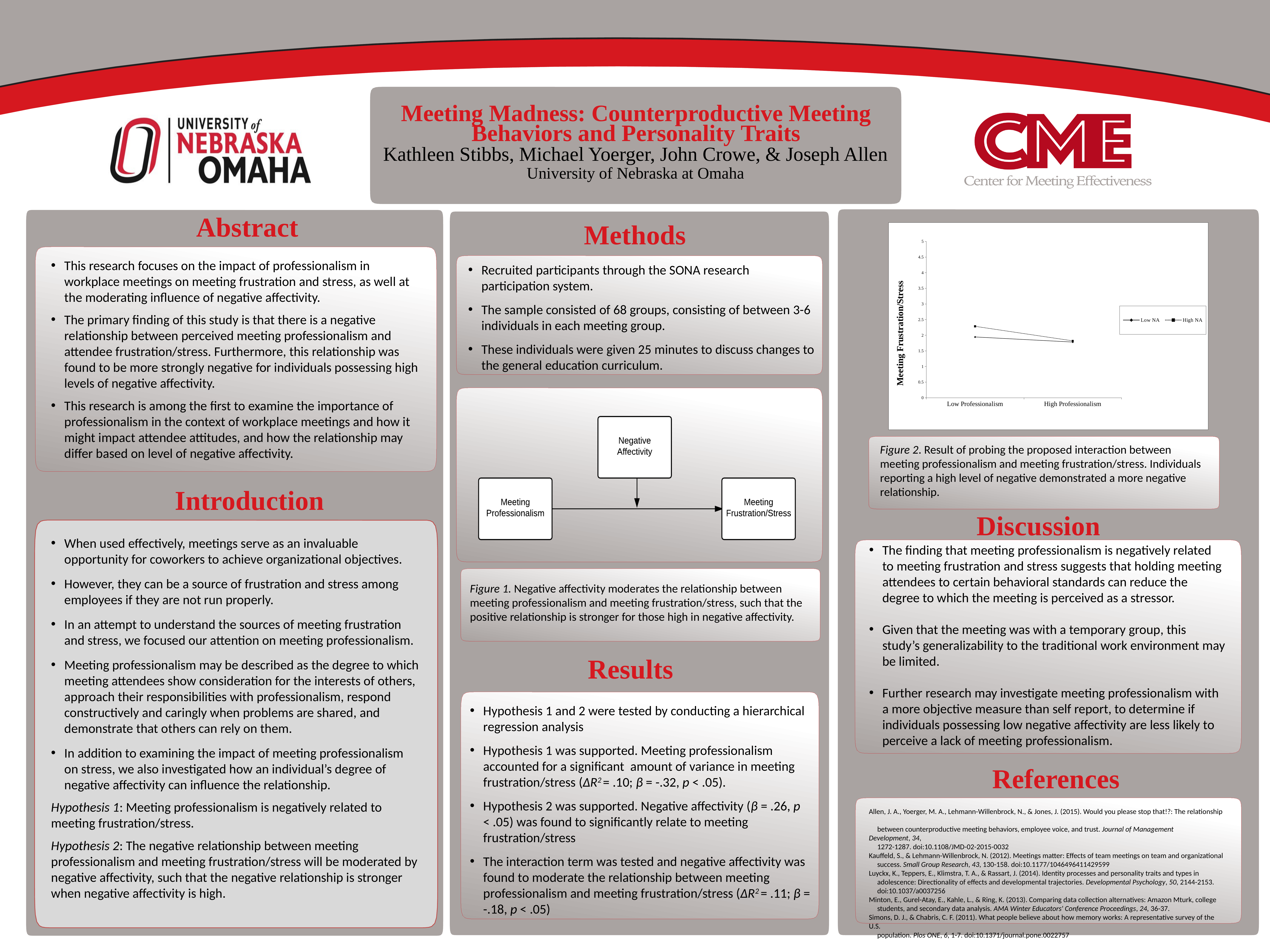
Is the value for High NA at Low Professionalism greater or less than 2? greater What are the two series named in the chart's legend? Low NA and High NA Is the value for Low NA at High Professionalism greater or less than 2? less How many categories are shown on the x axis of the chart? 2 At Low Professionalism, which series has the higher value, Low NA or High NA? High NA Is the value for Low NA at Low Professionalism greater or less than 3? less Which series shows the steeper decline across the x axis, Low NA or High NA? High NA What kind of chart is shown on the slide? line chart How many series does the chart's legend list? 2 What is the label of the y axis of the chart? Meeting Frustration/Stress Does the High NA line rise or fall from Low Professionalism to High Professionalism? fall